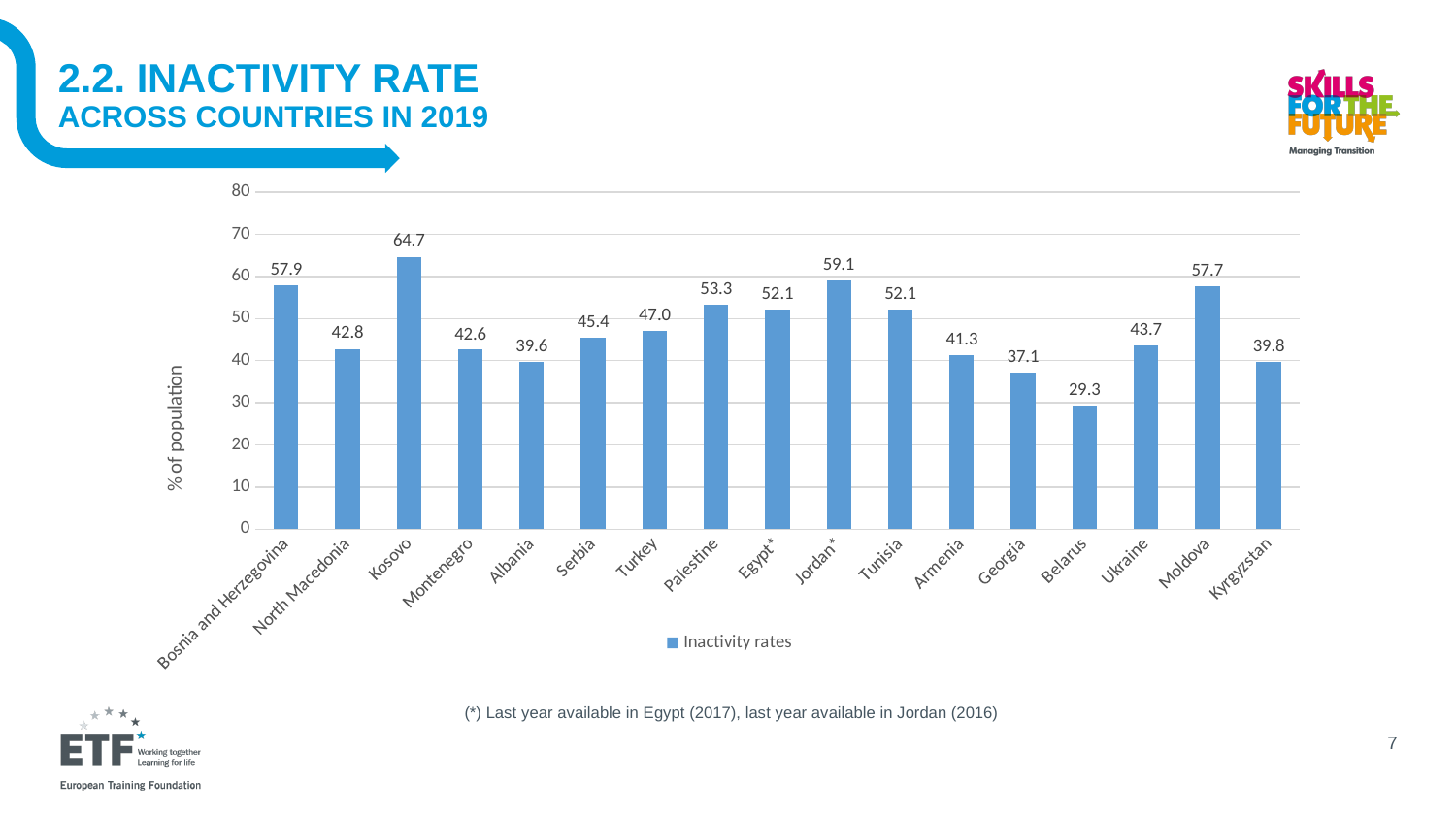
What is the difference between the inactivity rates of Kosovo and Belarus? 35.4 What is the inactivity rate for Moldova? 57.7 What is the inactivity rate for Belarus? 29.3 Is the inactivity rate for Georgia greater or less than 40? less How many countries are shown on the chart? 17 Which country has the lowest inactivity rate? Belarus What is the label of the y axis? % of population Which country has the highest inactivity rate? Kosovo Which has a higher inactivity rate, Jordan* or Palestine? Jordan* What kind of chart is shown on the slide? Bar chart What is the inactivity rate for Kosovo? 64.7 How many series does the legend list? 1